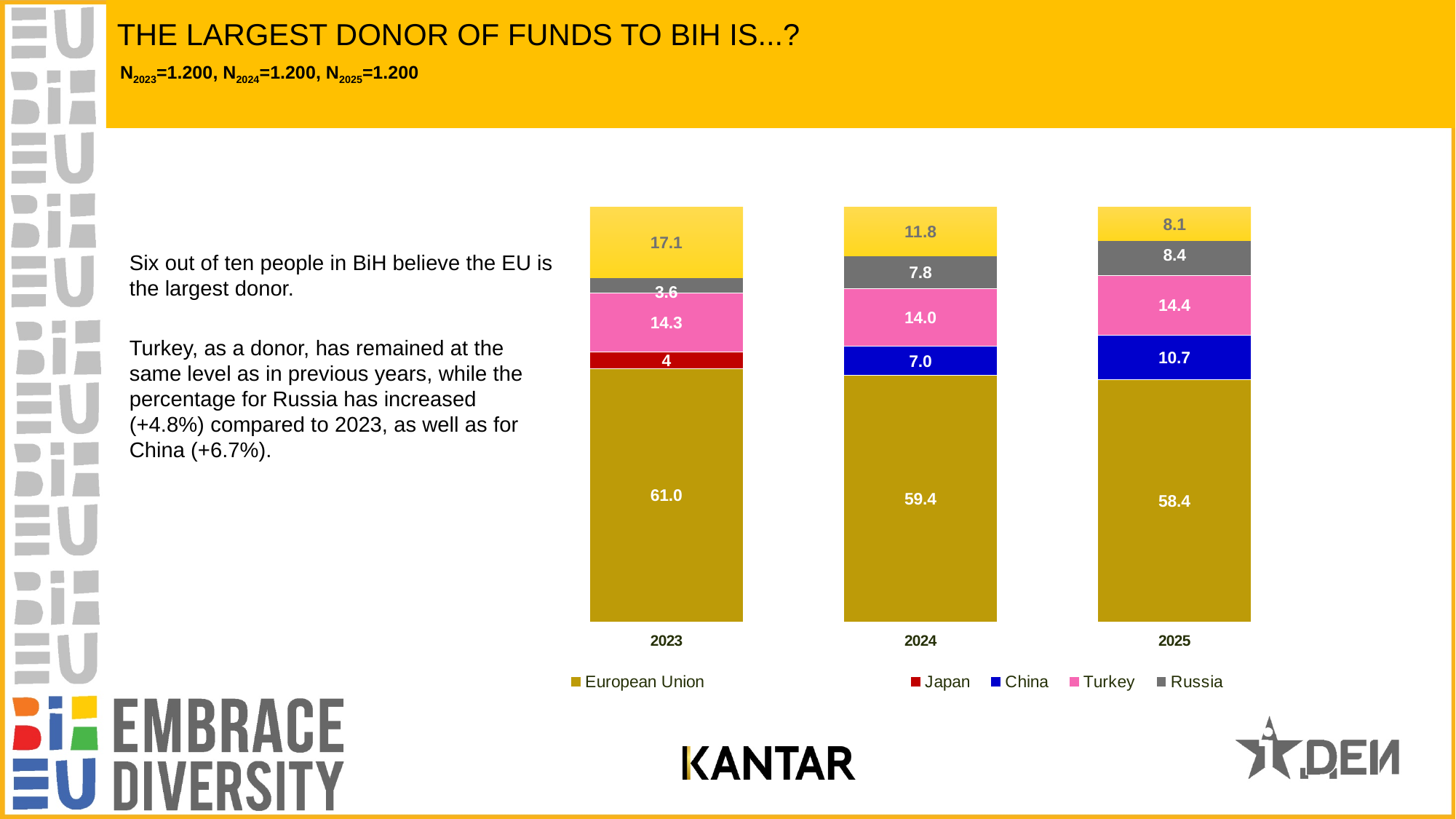
What is the value for Turkey in 2025? 14.4 What is the value for Japan in 2023? 4 Which is larger, the Russia value for 2024 or for 2023? 2024 What kind of chart is shown on the slide? Stacked bar chart How many series does the legend list? 5 How many years are shown on the x axis? 3 In which year is the European Union value highest? 2023 What is the value for European Union in 2023? 61.0 What is the difference between the China values for 2025 and 2024? 3.7 What is the value for Russia in 2025? 8.4 What is the difference between the European Union values for 2023 and 2025? 2.6 What is the value for China in 2024? 7.0